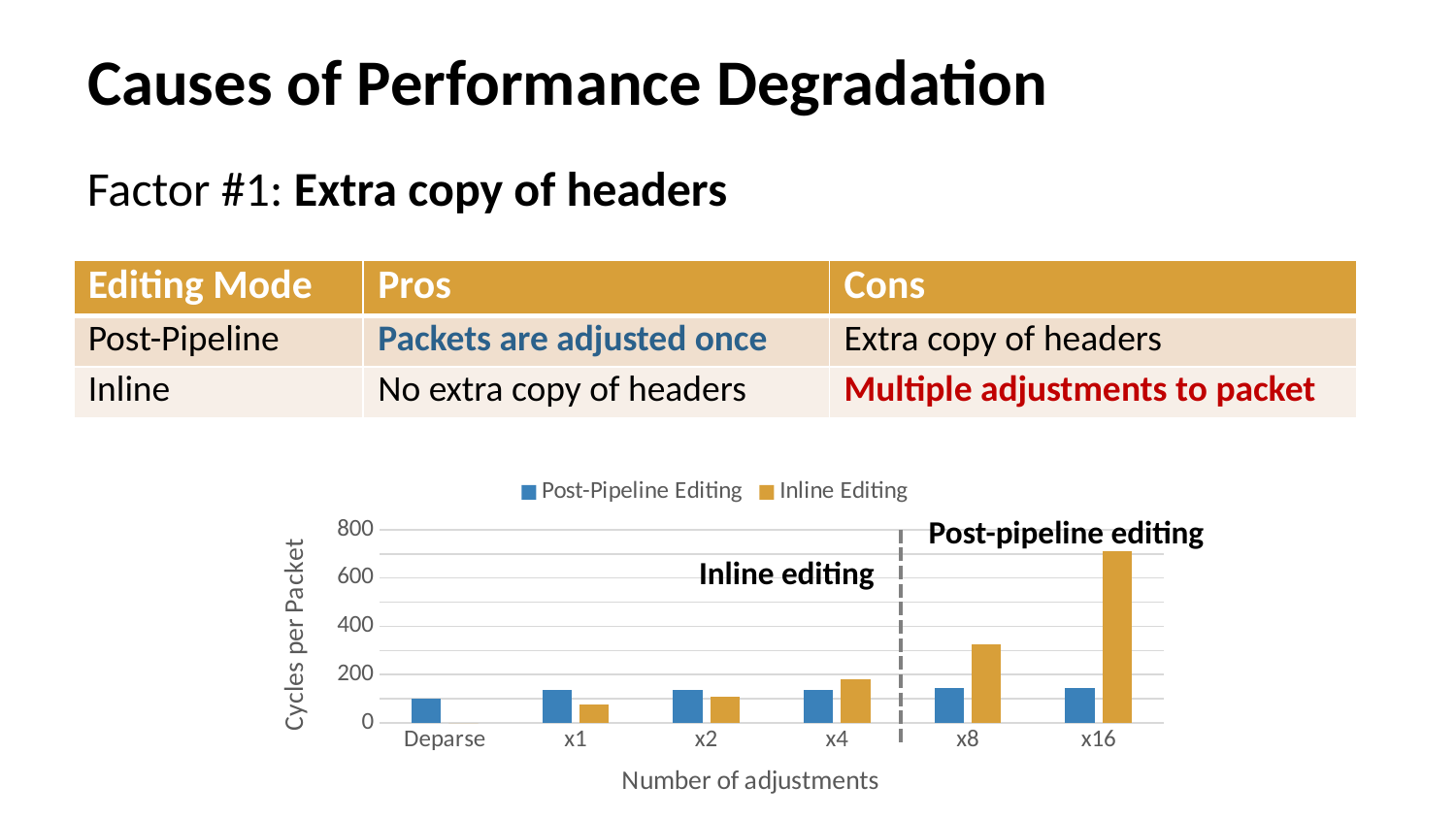
Is the Post-Pipeline Editing value for x16 greater or less than 200? less Do the Inline Editing values rise or fall as the number of adjustments increases from x1 to x16? rise What is the label of the chart's y axis? Cycles per Packet For which category is the Inline Editing value highest? x16 Is the Inline Editing value for x16 greater or less than 600? greater How many series does the chart legend list? 2 How many categories are shown on the x axis of the chart? 6 What kind of chart is shown on the slide? Bar chart Is the Inline Editing value for x8 greater or less than 200? greater At x16, which series has the larger value, Post-Pipeline Editing or Inline Editing? Inline Editing Among the categories with an Inline Editing bar, which has the lowest Inline Editing value? x1